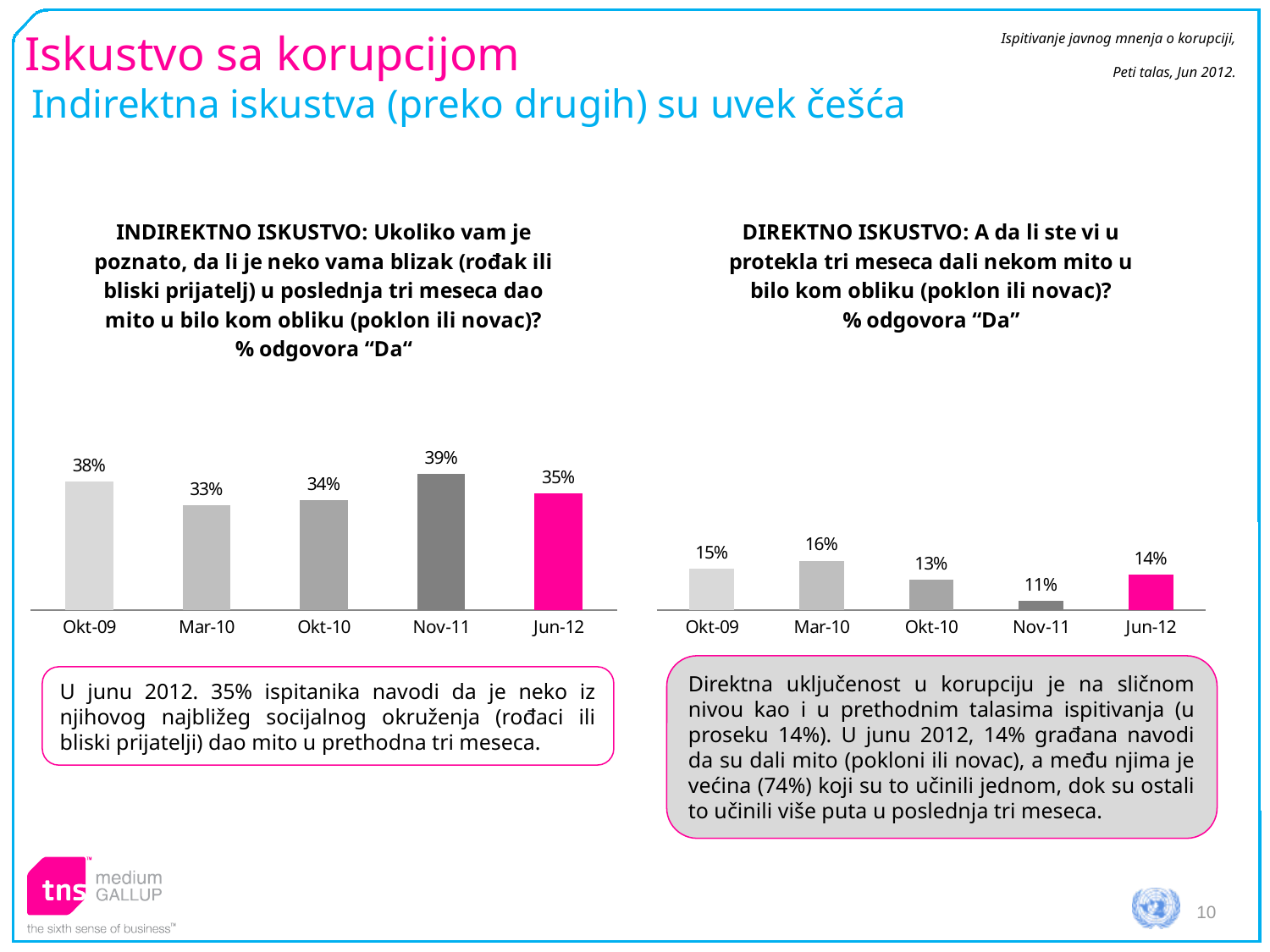
In the left chart (INDIREKTNO ISKUSTVO), what colour is the Jun-12 bar? Pink (magenta) In the right chart (DIREKTNO ISKUSTVO), which is larger, the value for Okt-09 or the value for Okt-10? Okt-09 What kind of chart is the right chart (DIREKTNO ISKUSTVO)? Bar chart In the left chart (INDIREKTNO ISKUSTVO), what is the value for Jun-12? 35% In the left chart (INDIREKTNO ISKUSTVO), what is the difference between the Nov-11 and Mar-10 values? 6% In the left chart (INDIREKTNO ISKUSTVO), which period has the highest value? Nov-11 In the right chart (DIREKTNO ISKUSTVO), which period has the lowest value? Nov-11 In the right chart (DIREKTNO ISKUSTVO), what is the difference between the Mar-10 and Nov-11 values? 5% In the right chart (DIREKTNO ISKUSTVO), what is the value for Nov-11? 11% How many periods are shown on the x axis of the left chart (INDIREKTNO ISKUSTVO)? 5 In the left chart (INDIREKTNO ISKUSTVO), which period has the lowest value? Mar-10 In the right chart (DIREKTNO ISKUSTVO), which period has the highest value? Mar-10